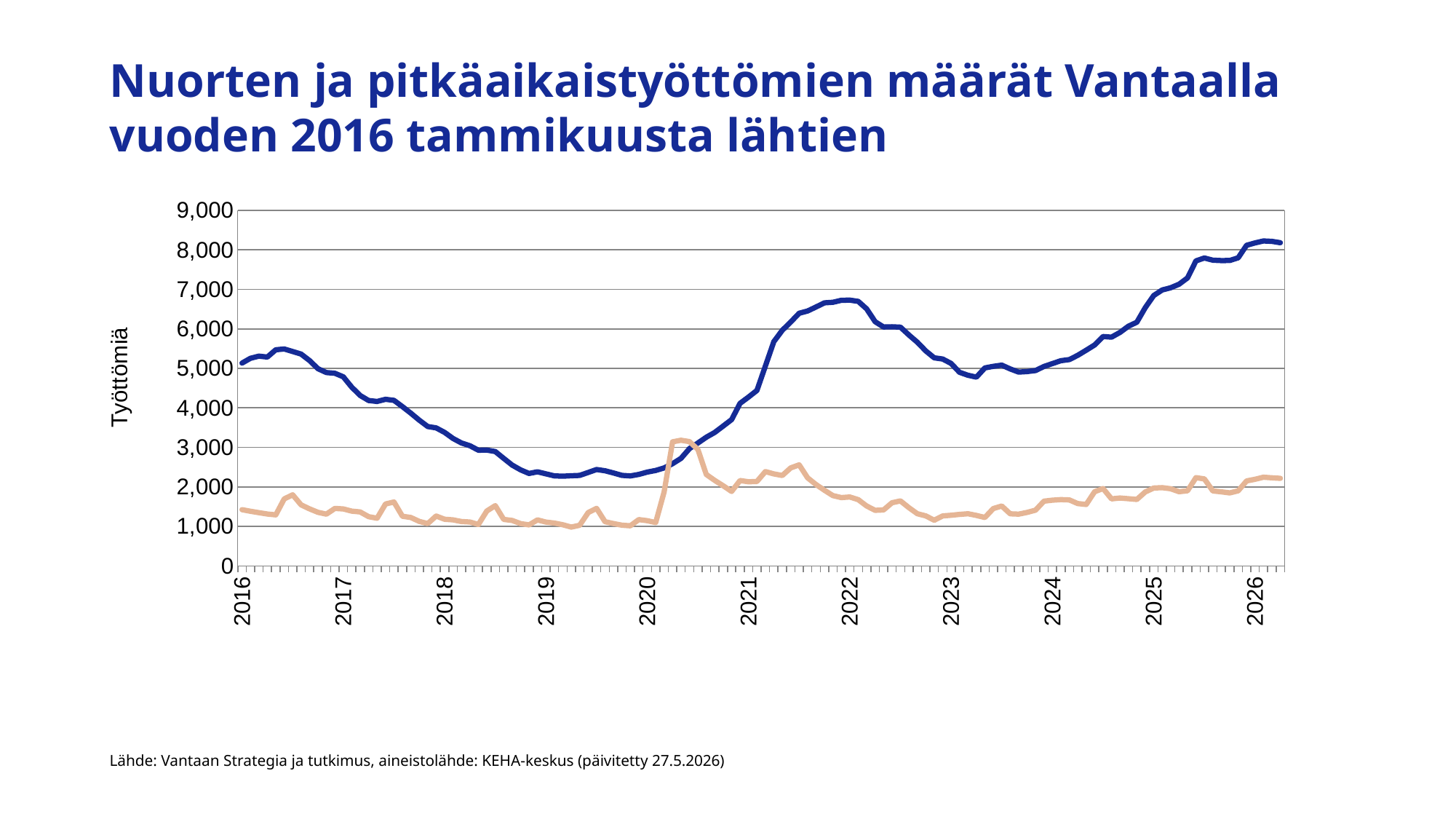
Is the value of the dark blue line at the start of 2022 greater or less than 6,000? greater Is the value of the light orange line at the start of 2019 greater or less than 2,000? less What kind of chart is shown on the slide? line chart What is the label on the vertical axis of the chart? Työttömiä How many data series (lines) are plotted on the chart? 2 How many year labels are shown on the horizontal axis? 11 What is the highest value shown on the vertical axis? 9,000 At the start of 2022, which line has the higher value, the dark blue line or the light orange line? dark blue line Is the value of the dark blue line at the start of 2026 greater or less than 8,000? greater Does the dark blue line rise or fall between 2016 and 2019? fall Does the dark blue line rise or fall between 2023 and 2026? rise